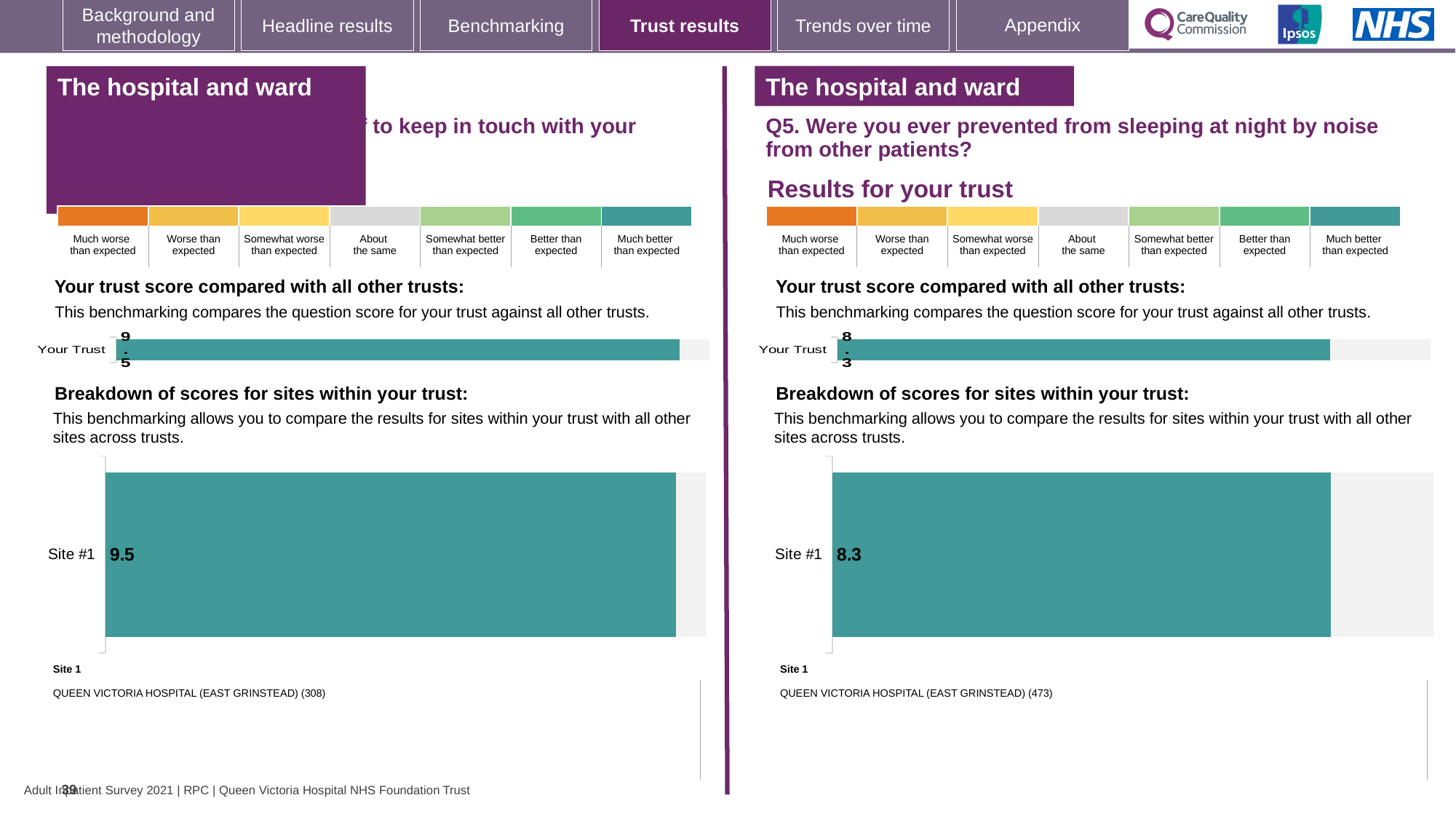
What kind of chart is used to show the Site #1 score on the right panel (Q5)? Bar chart On the left panel, is the Your Trust score greater or less than 9? greater On the right panel (Q5), what is the score shown for Site #1 in the breakdown of scores for sites chart? 8.3 On the left panel, what is the score shown for Your Trust in the 'Your trust score compared with all other trusts' chart? 9.5 How many sites are listed in the 'Breakdown of scores for sites within your trust' chart on the right panel (Q5)? 1 Which site name is listed as Site 1 below the breakdown chart on the right panel (Q5)? QUEEN VICTORIA HOSPITAL (EAST GRINSTEAD) (473) On the right panel (Q5, prevented from sleeping at night by noise from other patients), what is the score shown for Your Trust? 8.3 On the left panel, what is the score shown for Site #1 in the 'Breakdown of scores for sites within your trust' chart? 9.5 What colour are the bars for Your Trust and Site #1 on both panels? Teal On the right panel (Q5), is the Site #1 score greater or less than 9? less Which is larger: the Your Trust score on the left panel or the Your Trust score on the right panel (Q5)? Left panel (9.5) What is the difference between the Site #1 score on the left panel (9.5) and the Site #1 score on the right panel (8.3)? 1.2